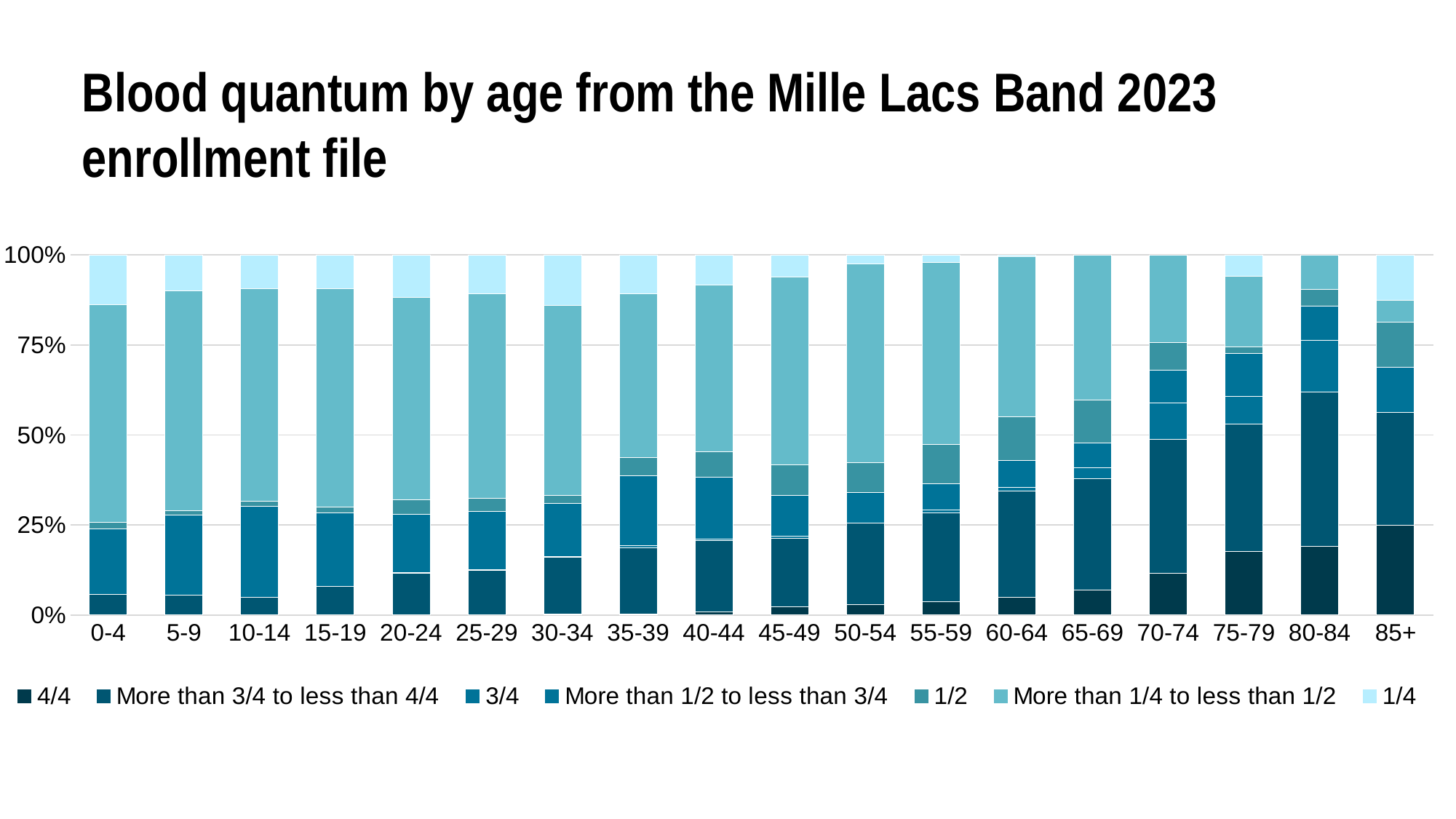
Which age group has the larger 4/4 share, 0-4 or 80-84? 80-84 What kind of chart is shown on the slide? Stacked bar chart How many series does the legend list? 7 Is the 'More than 1/4 to less than 1/2' share for the 0-4 age group greater or less than 50%? greater How many age groups are shown along the x axis? 18 Which age group has the largest 4/4 share? 85+ Does the 'More than 1/4 to less than 1/2' share generally rise or fall as age increases along the x axis? fall Which legend entry is shown in the lightest colour? 1/4 Does the 4/4 share generally rise or fall as age increases along the x axis? rise Is the 4/4 share for the 80-84 age group greater or less than 25%? less What is the title of the chart? Blood quantum by age from the Mille Lacs Band 2023 enrollment file Is the 1/4 share for the 0-4 age group greater or less than 25%? less